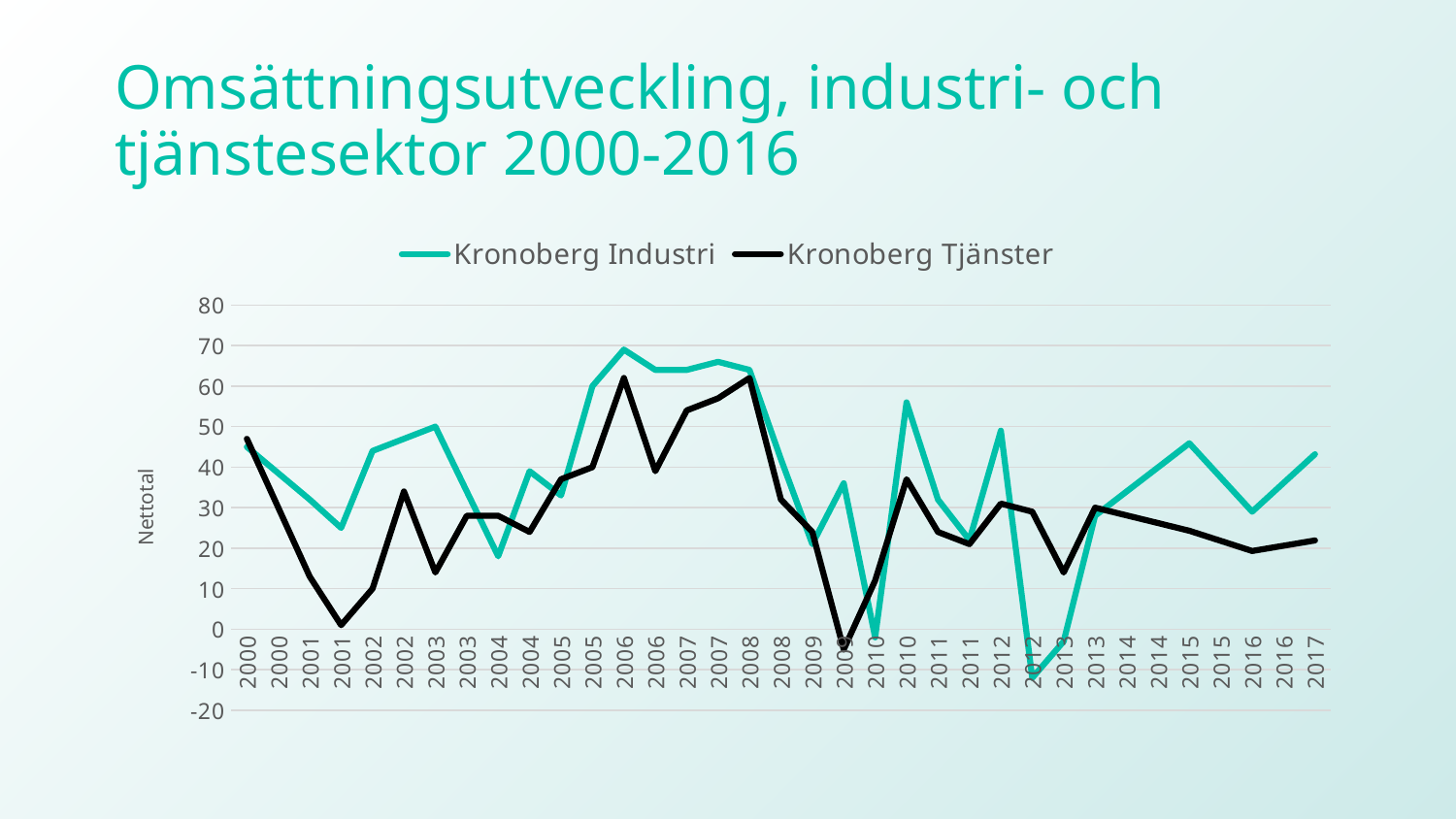
At which x-axis point does Kronoberg Industri reach its highest value? 2006 (first point) Does the Kronoberg Industri line rise or fall between the 2013 points and the first 2015 point? rise At the 2017 point, which series has the higher value, Kronoberg Industri or Kronoberg Tjänster? Kronoberg Industri Is the value for Kronoberg Industri at the first 2006 point greater or less than 60? greater Is the value for Kronoberg Industri at the second 2012 point greater or less than 0? less Is the value for Kronoberg Tjänster at the first 2000 point greater or less than 40? greater How many series does the legend list? 2 At which x-axis point does Kronoberg Industri reach its lowest value? 2012 (second point) What kind of chart is shown on the slide? line chart What are the two series named in the legend? Kronoberg Industri and Kronoberg Tjänster What is the label on the vertical axis? Nettotal